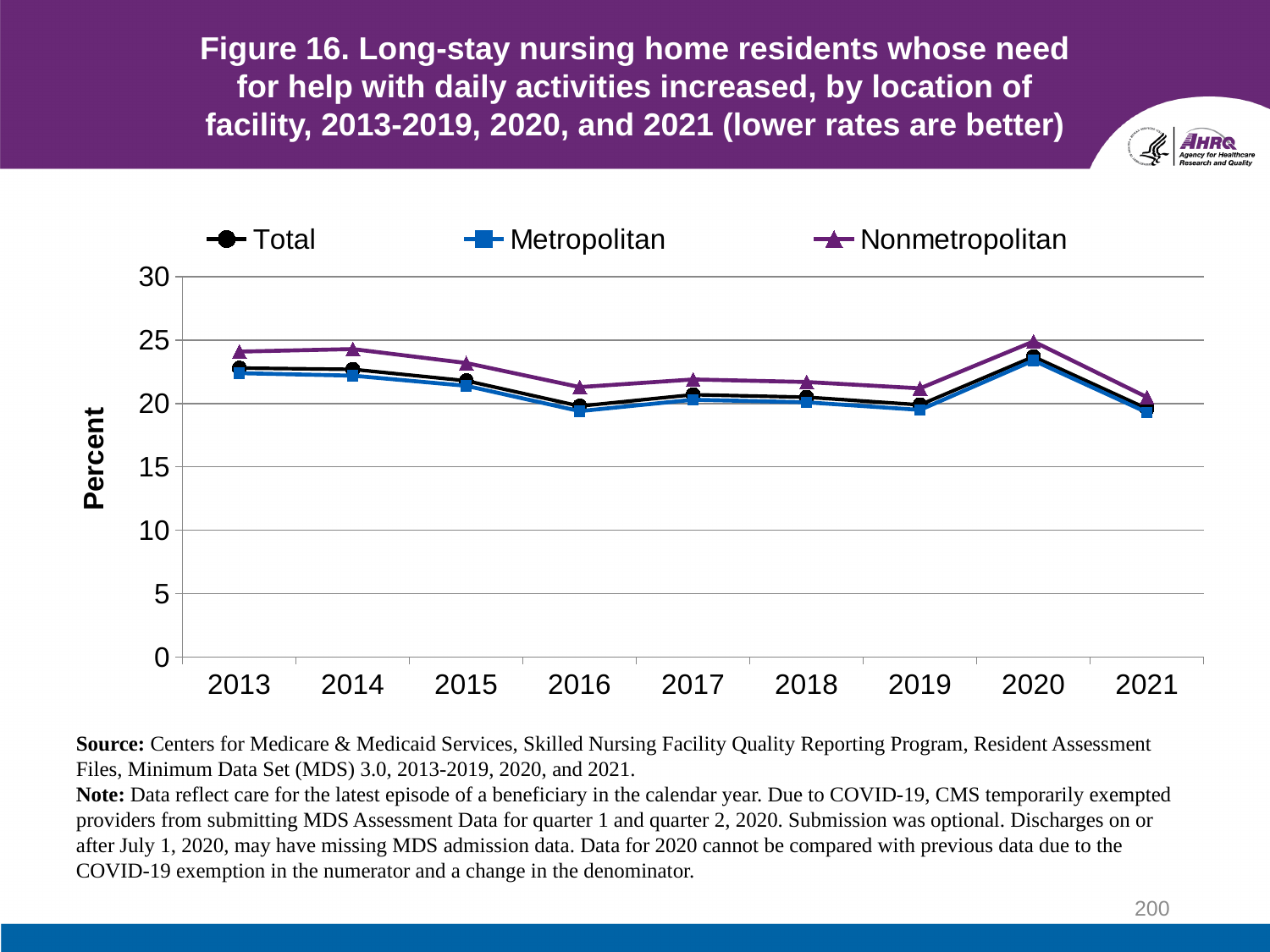
Is the Metropolitan value for 2014 greater or less than 20? greater How many series does the legend list? 3 What is the label on the y axis? Percent In 2013, which is larger, the Nonmetropolitan value or the Metropolitan value? Nonmetropolitan Do the values for all three series rise or fall from 2019 to 2020? rise Which series has the lowest value in 2016? Metropolitan How many years are plotted along the x axis? 9 What kind of chart is shown on the slide? Line chart Do the values for all three series rise or fall from 2020 to 2021? fall Is the Nonmetropolitan value for 2020 greater or less than 20? greater Is the Total value for 2021 greater or less than 25? less Which series has the highest value in 2020? Nonmetropolitan